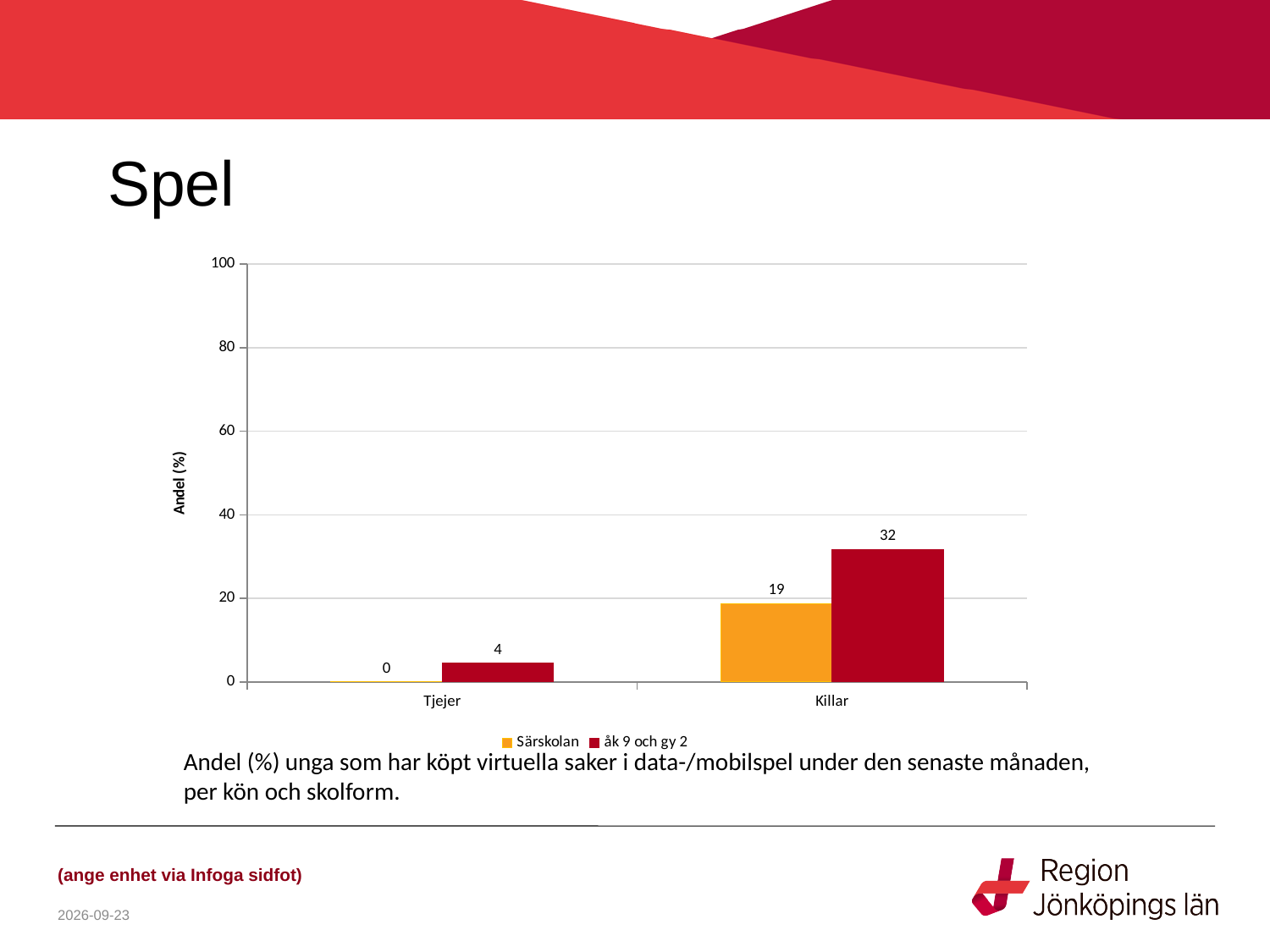
How many series does the legend list? 2 What is the value for Särskolan in the Tjejer category? 0 For Killar, which series has the larger value, Särskolan or åk 9 och gy 2? åk 9 och gy 2 Is the value for åk 9 och gy 2 in the Killar category greater or less than 40? less What is the difference between the åk 9 och gy 2 value and the Särskolan value for Killar? 13 How many categories are shown on the x axis? 2 Which category has the highest value for åk 9 och gy 2? Killar Which category has the lowest value for Särskolan? Tjejer What is the value for åk 9 och gy 2 in the Killar category? 32 What is the value for åk 9 och gy 2 in the Tjejer category? 4 What is the value for Särskolan in the Killar category? 19 What kind of chart is shown on the slide? bar chart